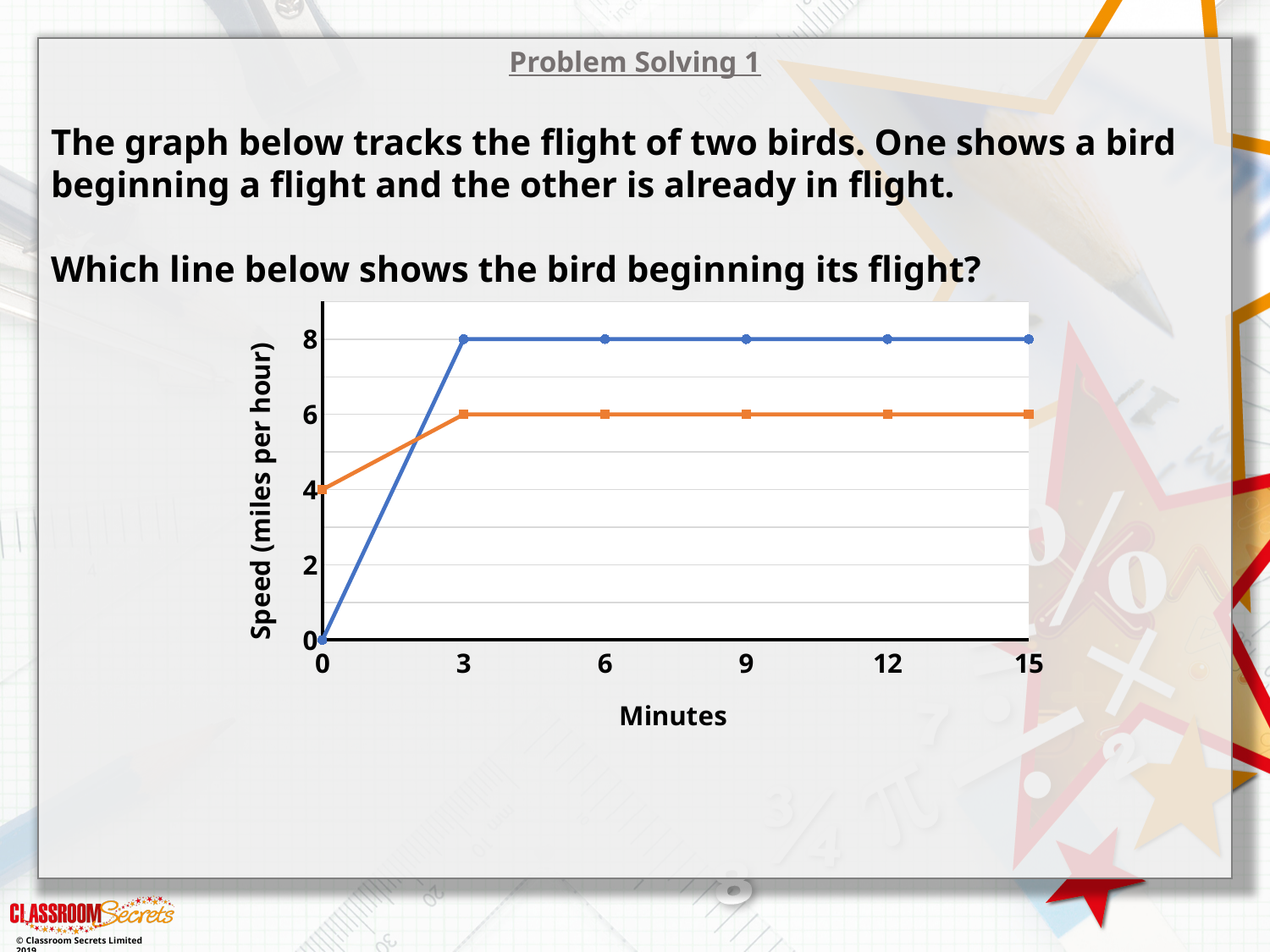
What is the label of the y axis? Speed (miles per hour) Which line has the higher speed at 12 minutes, blue or orange? blue What is the speed of the blue line at 0 minutes? 0 What is the speed of the orange line at 0 minutes? 4 Does the blue line rise, fall or stay flat between 3 and 15 minutes? stays flat Which line has the higher speed at 0 minutes, blue or orange? orange What kind of chart is shown on the slide? line chart What is the speed of the blue line at 3 minutes? 8 What is the speed of the orange line at 15 minutes? 6 What is the label of the x axis? Minutes How many lines are plotted on the chart? 2 What is the difference in speed between the blue line and the orange line at 9 minutes? 2